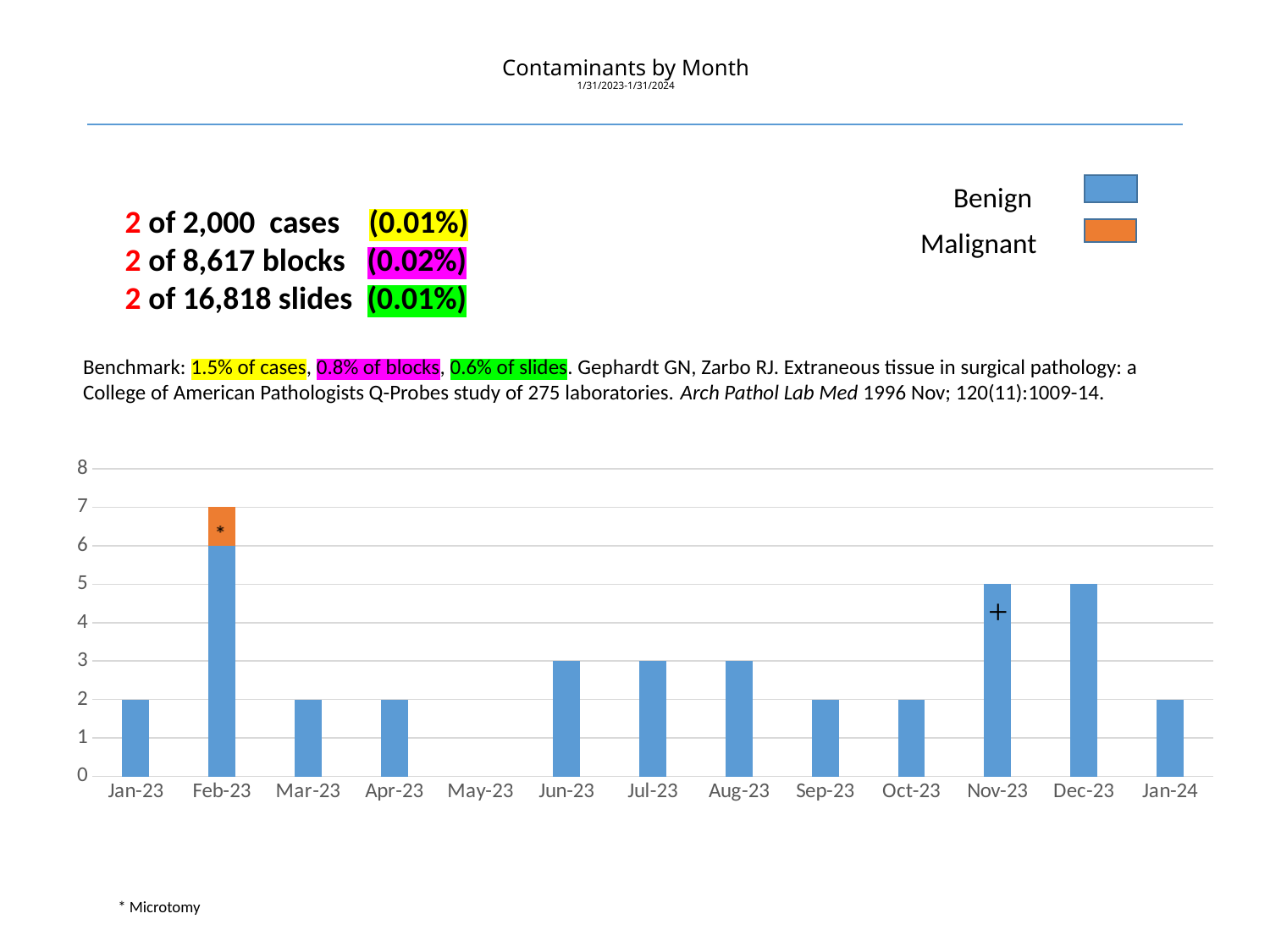
Which month has the tallest bar in the chart? Feb-23 How many series does the legend list? 2 What is the value for Nov-23? 5 How many months are shown on the x axis of the chart? 13 Which is larger, the value for Nov-23 or the value for Jun-23? Nov-23 What is the Benign value for Feb-23? 6 Which series is shown in orange in the legend? Malignant What is the total height of the stacked bar for Feb-23? 7 What kind of chart is shown on the slide? bar chart Is the value for Dec-23 greater or less than 4? greater What is the value for Jun-23? 3 Which month has no bar (the lowest value) in the chart? May-23